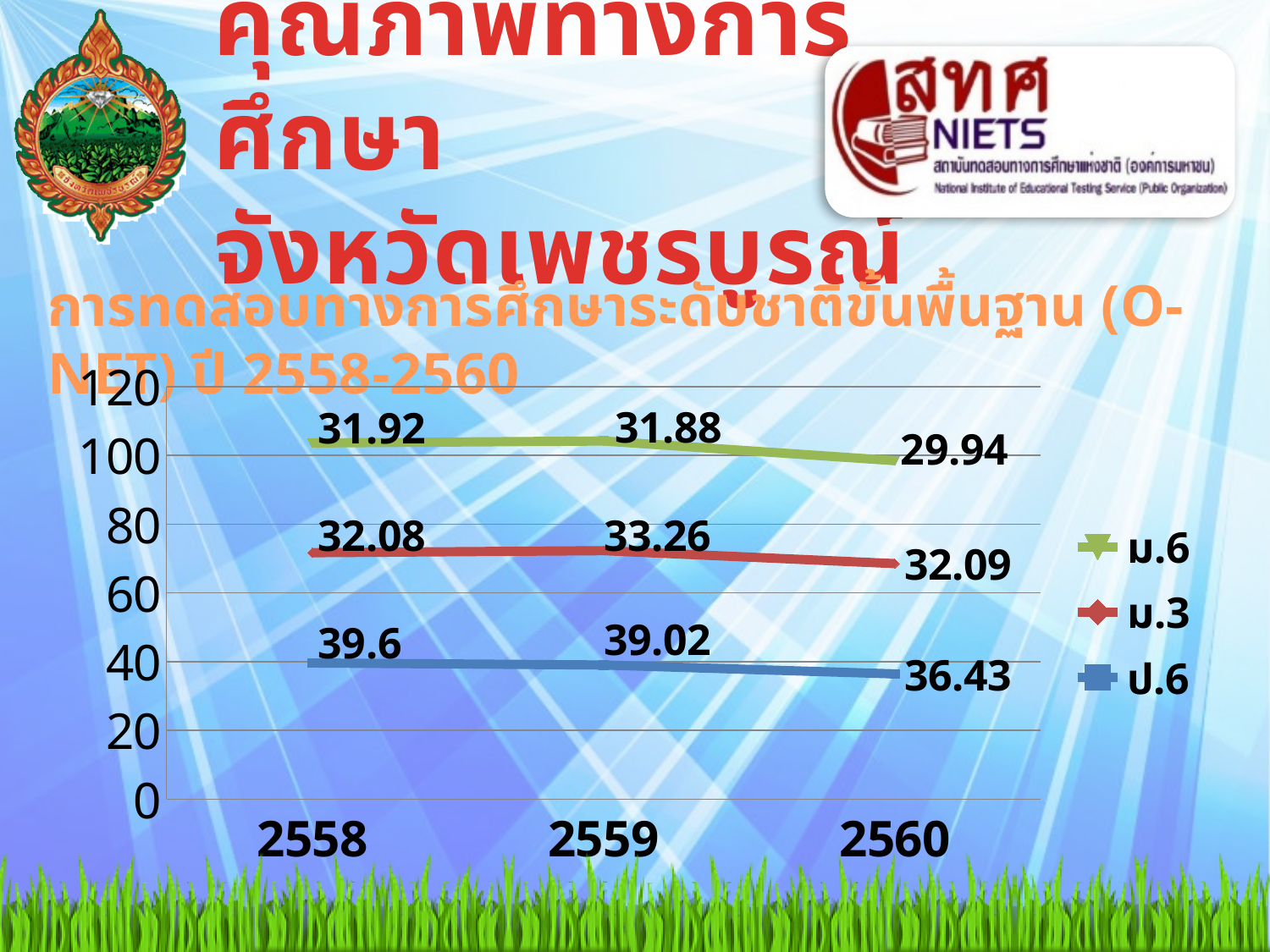
In which year is the value for ม.6 lowest? 2560 What is the value for ป.6 in 2558? 39.6 In which year is the value for ม.3 highest? 2559 How many years are shown on the x axis? 3 How many series does the legend list? 3 Do the values for ป.6 rise or fall from 2558 to 2560? fall What is the value for ม.3 in 2559? 33.26 What is the difference between the ป.6 values in 2558 and 2560? 3.17 Which is larger in 2558, the value for ป.6 or the value for ม.6? ป.6 What is the value for ป.6 in 2560? 36.43 What kind of chart is shown on the slide? line chart What is the value for ม.6 in 2560? 29.94